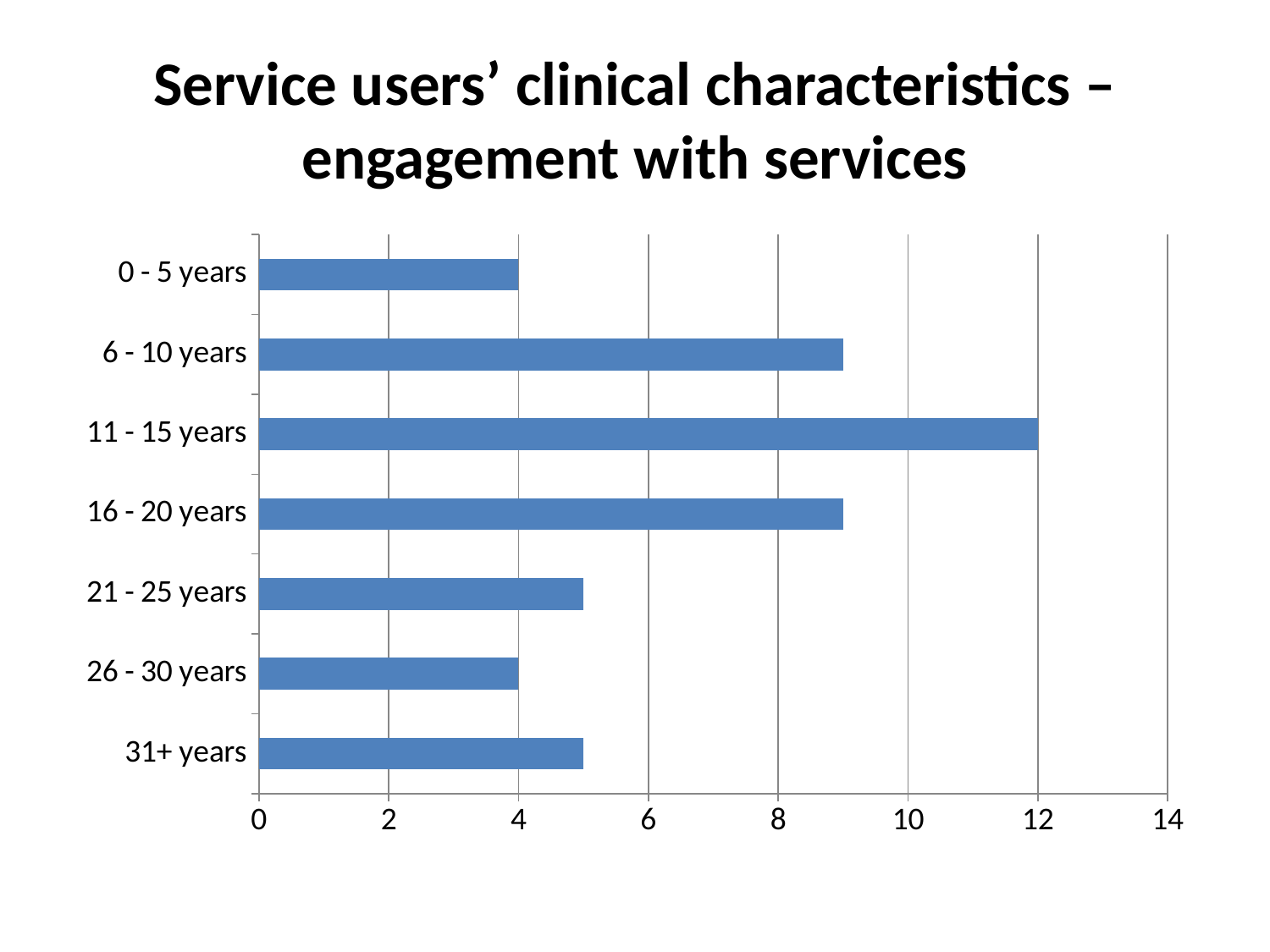
Which is larger, the value for 6 - 10 years or the value for 21 - 25 years? 6 - 10 years What is the title of the slide? Service users' clinical characteristics – engagement with services Is the value for 16 - 20 years greater or less than 10? less Is the value for 6 - 10 years greater or less than 8? greater What is the value for 26 - 30 years? 4 What type of chart is shown on the slide? bar chart What is the value for 0 - 5 years? 4 What is the value for 11 - 15 years? 12 How many categories are shown on the chart? 7 Which category has the highest value? 11 - 15 years Is the value for 31+ years greater or less than 6? less What is the difference between the values for 11 - 15 years and 0 - 5 years? 8